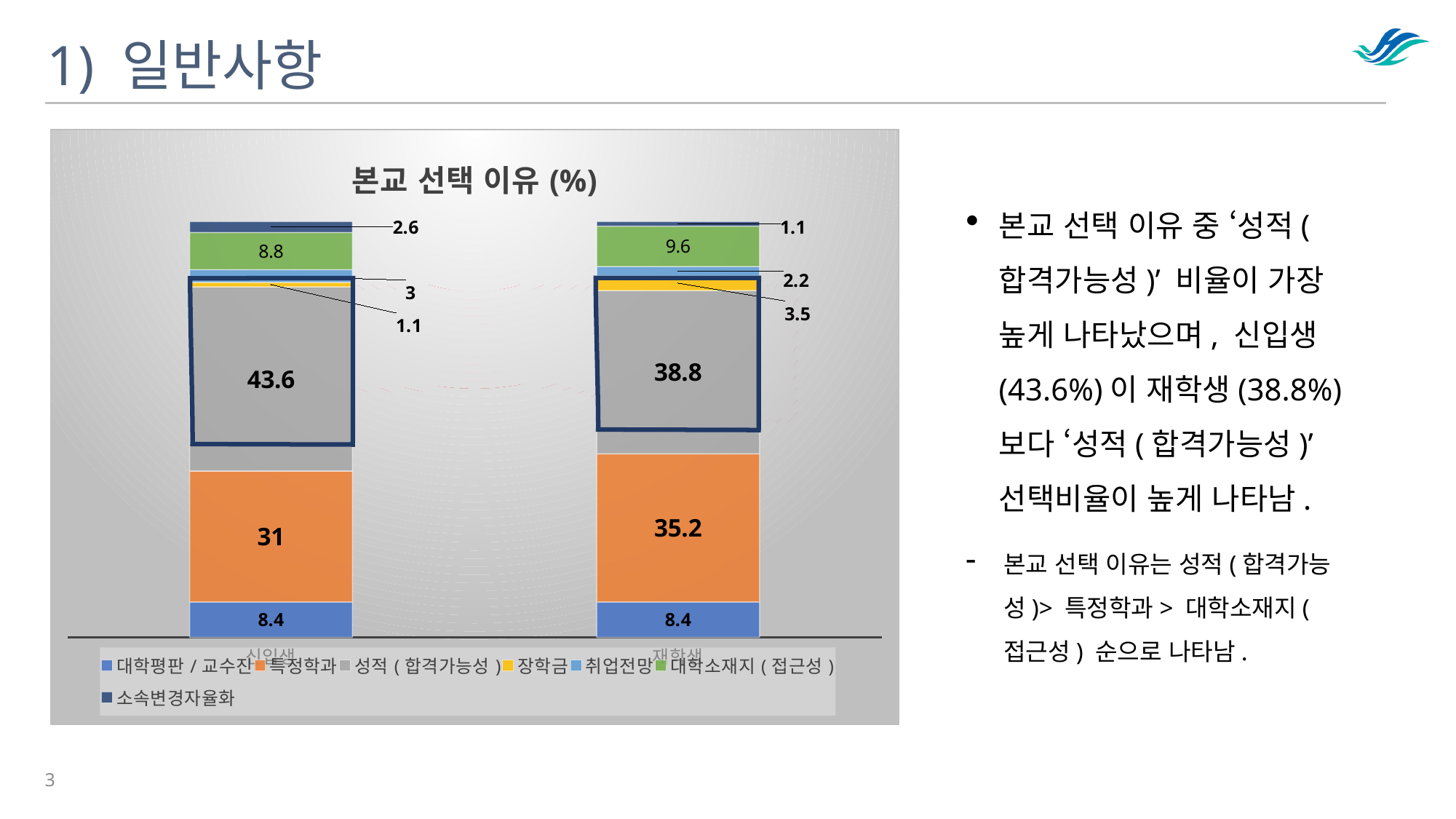
What is the difference between the 특정학과 values for 재학생 and 신입생? 4.2 Which series has the largest segment in the 신입생 bar? 성적 ( 합격가능성 ) What is the value of 성적 ( 합격가능성 ) for 신입생? 43.6 What is the value of 대학소재지 ( 접근성 ) for 재학생? 9.6 What is the title of the chart? 본교 선택 이유 (%) What is the difference between the 성적 ( 합격가능성 ) values for 신입생 and 재학생? 4.8 How many series does the chart's legend list? 7 What is the value of 특정학과 for 재학생? 35.2 What is the value of 대학평판 / 교수진 for 신입생? 8.4 What kind of chart is shown on the slide? Stacked bar chart How many categories (groups) are shown on the x axis of the chart? 2 Which group has the larger 특정학과 value, 신입생 or 재학생? 재학생